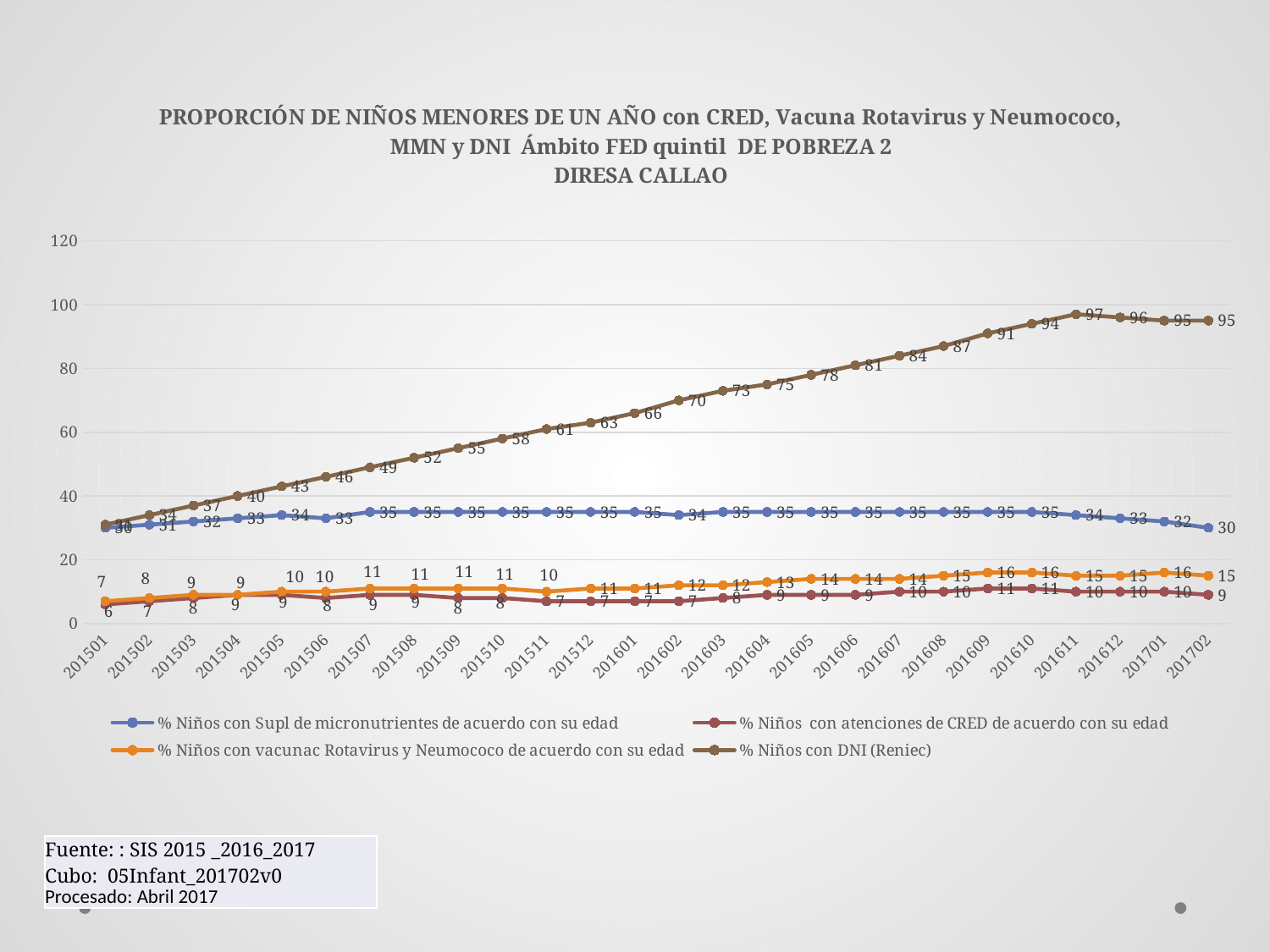
By how much did % Niños con DNI (Reniec) increase from 201501 to 201702? 64 Is the value for % Niños con DNI (Reniec) at 201608 greater or less than 80? greater At 201702, which is larger: % Niños con Supl de micronutrientes or % Niños con vacunac Rotavirus y Neumococo? % Niños con Supl de micronutrientes What is the value of % Niños con vacunac Rotavirus y Neumococo de acuerdo con su edad at 201702? 15 What kind of chart is shown on the slide? line chart What is the value of % Niños con DNI (Reniec) at 201501? 31 Does % Niños con DNI (Reniec) generally rise or fall from 201501 to 201611? rise At which period does % Niños con DNI (Reniec) reach its highest value? 201611 How many series does the legend list? 4 What is the value of % Niños con DNI (Reniec) at 201702? 95 How many time points are plotted along the x axis? 26 What is the value of % Niños con atenciones de CRED de acuerdo con su edad at 201501? 6